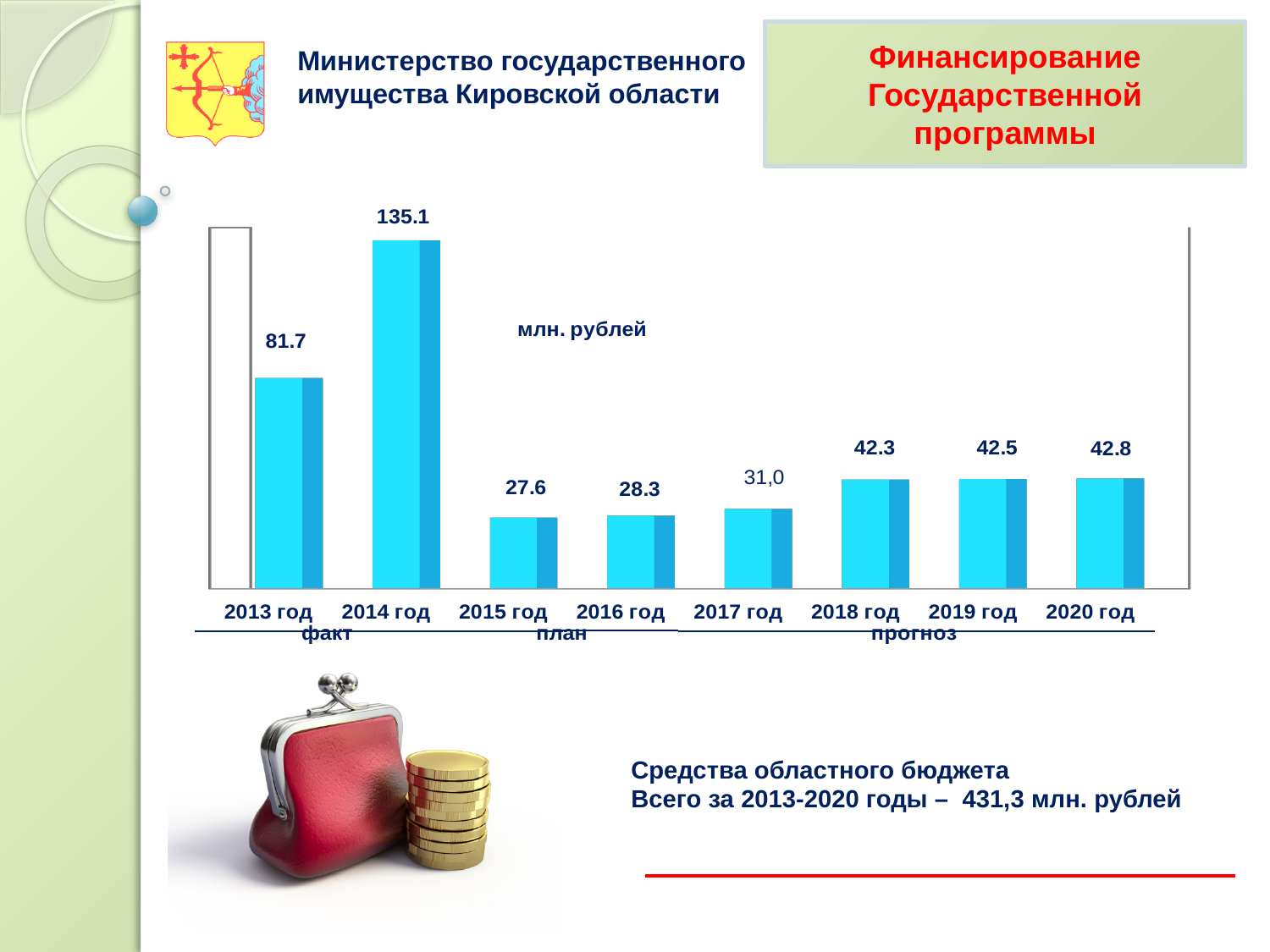
Which is larger, the value for 2013 год or 2014 год? 2014 год What is the value for 2017 год? 31,0 What is the value for 2014 год? 135.1 What is the value for 2013 год? 81.7 What is the value for 2020 год? 42.8 Which year has the highest value? 2014 год Do the values rise or fall from 2015 год to 2020 год? rise How many years are shown on the chart? 8 What is the difference between the values for 2020 год and 2015 год? 15.2 What is the difference between the values for 2014 год and 2013 год? 53.4 What kind of chart is shown on the slide? bar chart Which year has the lowest value? 2015 год